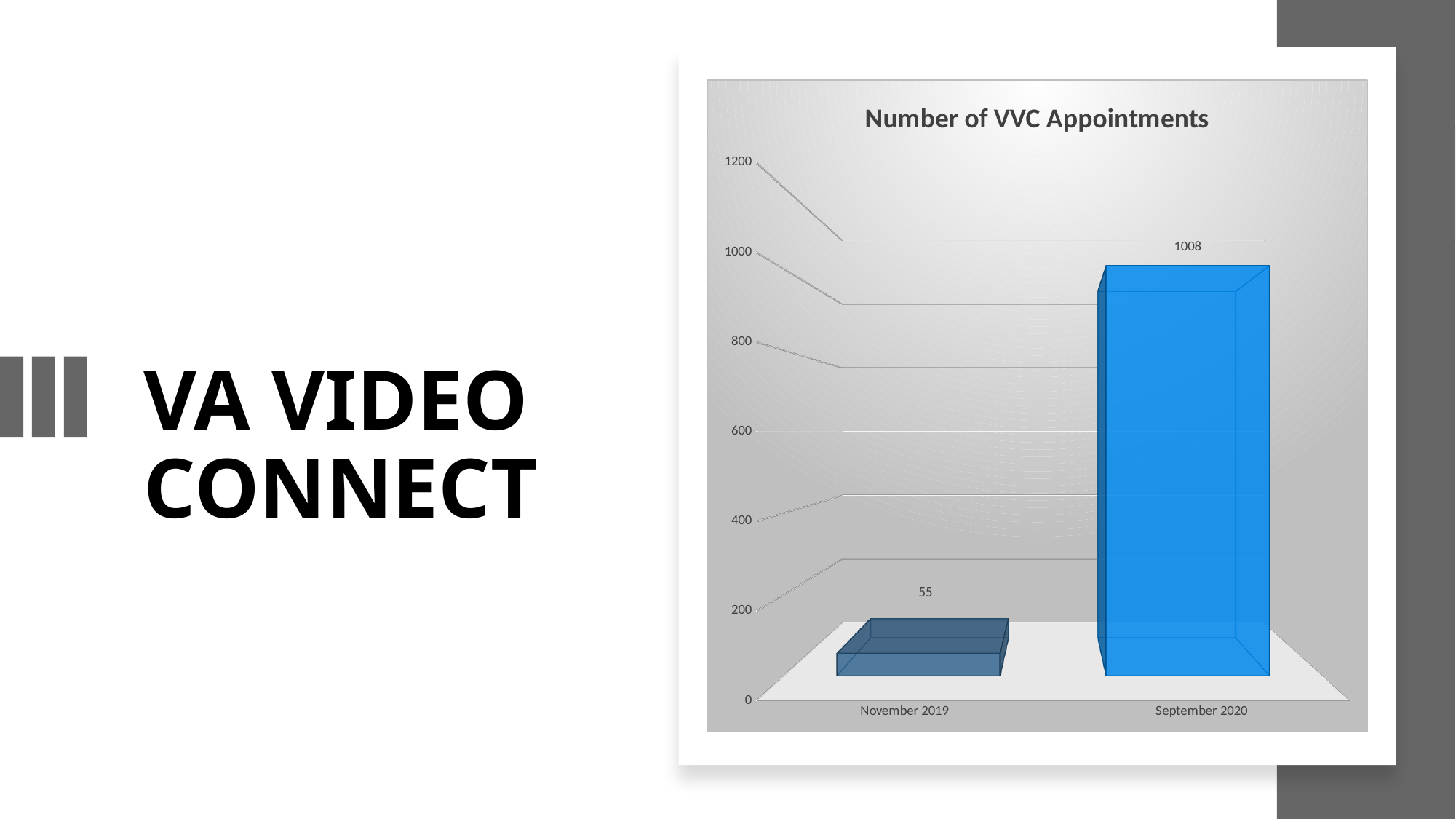
What kind of chart is shown on the slide? bar chart Which category has the lowest number of VVC appointments? November 2019 Do the values rise or fall from November 2019 to September 2020? rise Which has more VVC appointments, November 2019 or September 2020? September 2020 What is the difference in VVC appointments between September 2020 and November 2019? 953 Is the value for November 2019 greater or less than 200? less What is the title of the chart? Number of VVC Appointments Is the value for September 2020 greater or less than 800? greater What is the number of VVC appointments for November 2019? 55 What is the number of VVC appointments for September 2020? 1008 Which category has the highest number of VVC appointments? September 2020 How many categories are shown on the chart? 2